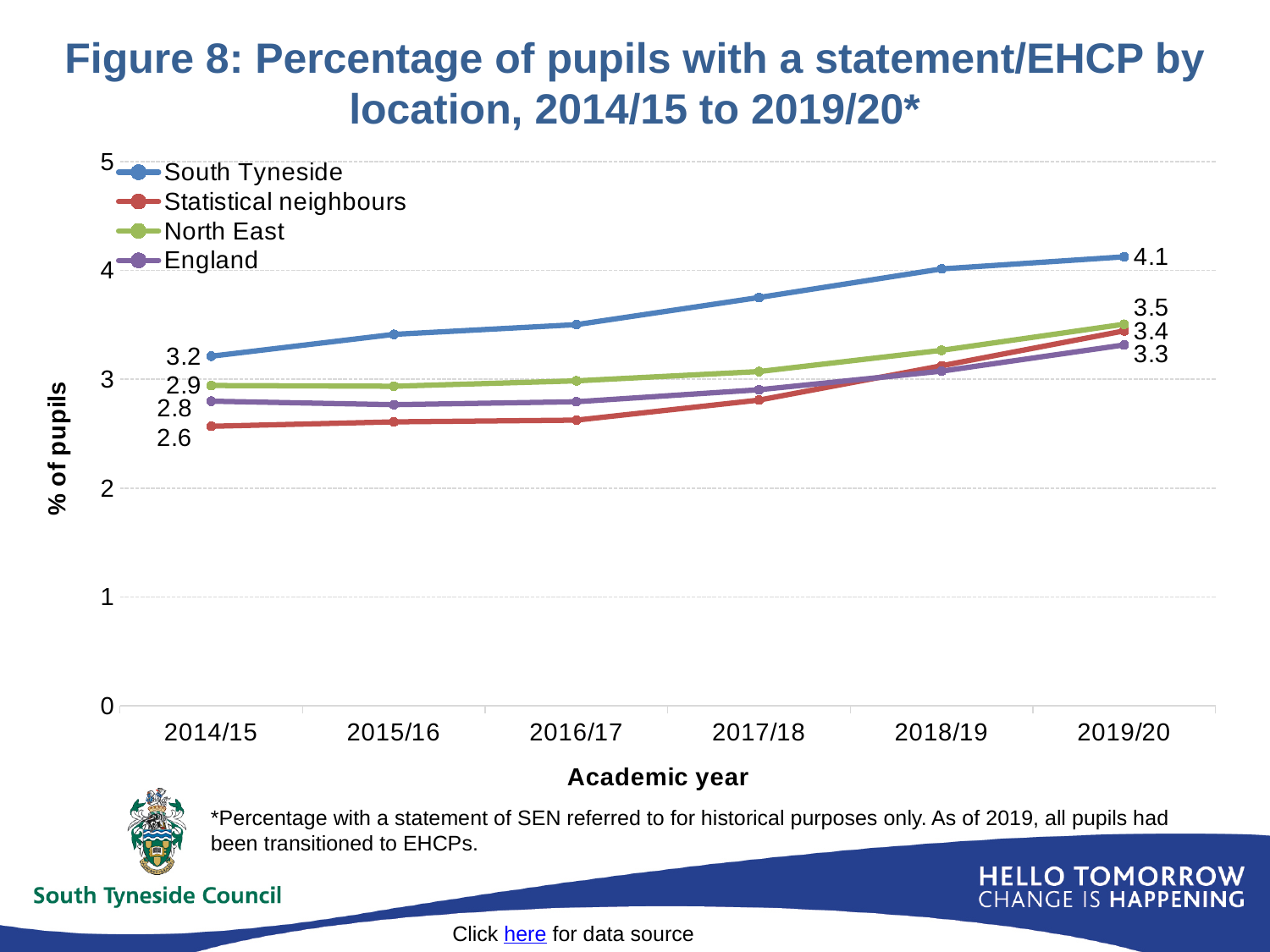
What is the value for North East in 2019/20? 3.5 What is the difference between South Tyneside and North East in 2019/20? 0.6 What is the value for England in 2019/20? 3.3 How many series does the legend list? 4 By how much did the South Tyneside value increase from 2014/15 to 2019/20? 0.9 What is the value for South Tyneside in 2019/20? 4.1 What is the value for Statistical neighbours in 2014/15? 2.6 What kind of chart is shown? Line chart Which series has the highest value in 2019/20? South Tyneside Which series has the lowest value in 2014/15? Statistical neighbours What is the value for South Tyneside in 2014/15? 3.2